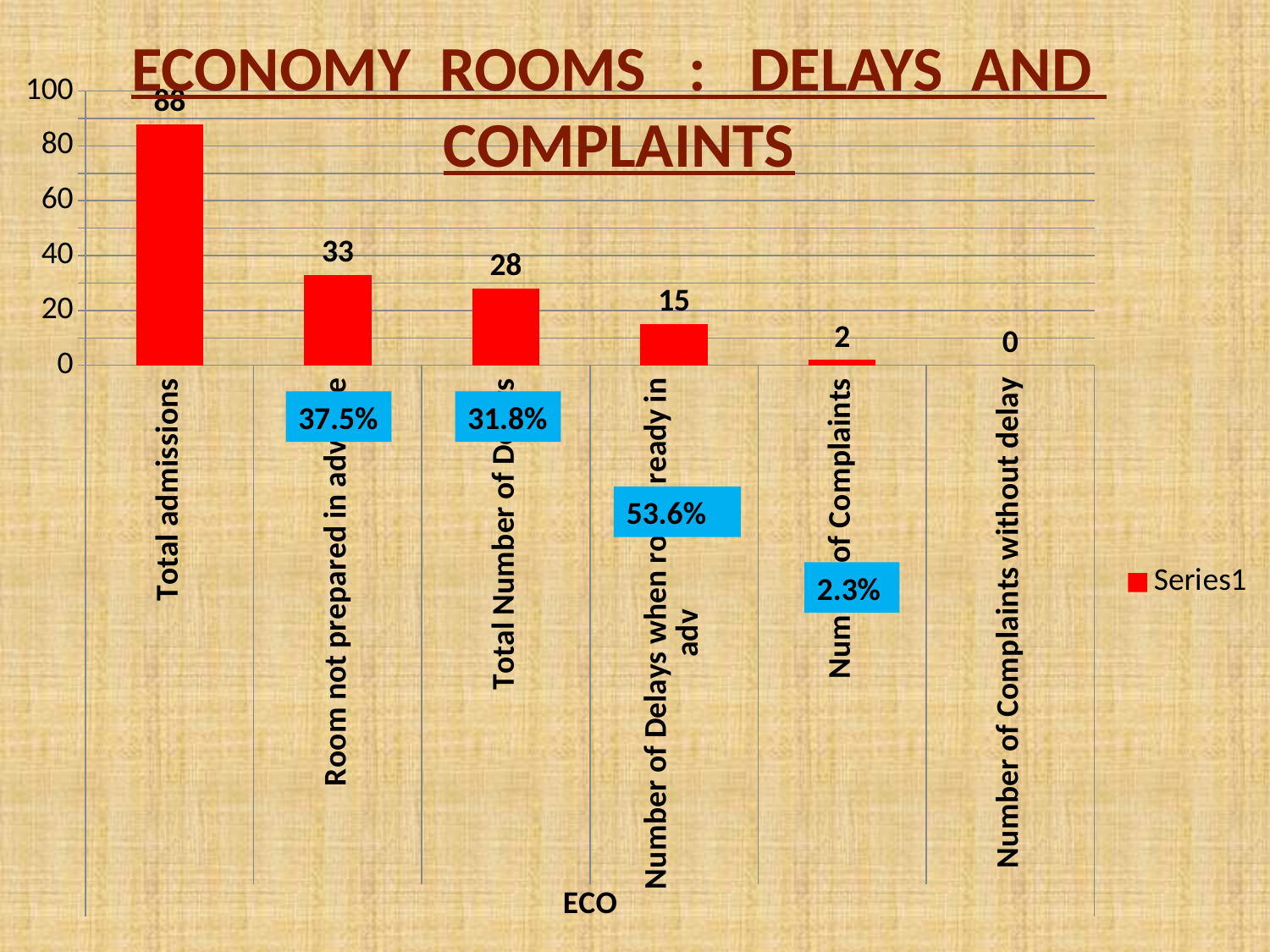
What is the title of the chart? ECONOMY ROOMS : DELAYS AND COMPLAINTS Which category has the highest value? Total admissions Which category has the lowest value? Number of Complaints without delay Which is larger: the value for Total Number of Delays or the value for Number of Complaints? Total Number of Delays What is the value for Total admissions? 88 What is the value for Number of Complaints? 2 What kind of chart is shown on the slide? bar chart How many categories are shown on the x axis? 6 What is the value for Number of Complaints without delay? 0 What is the difference between Total admissions and Total Number of Delays? 60 What is the value for Total Number of Delays? 28 Is the value for Total admissions greater or less than 80? greater